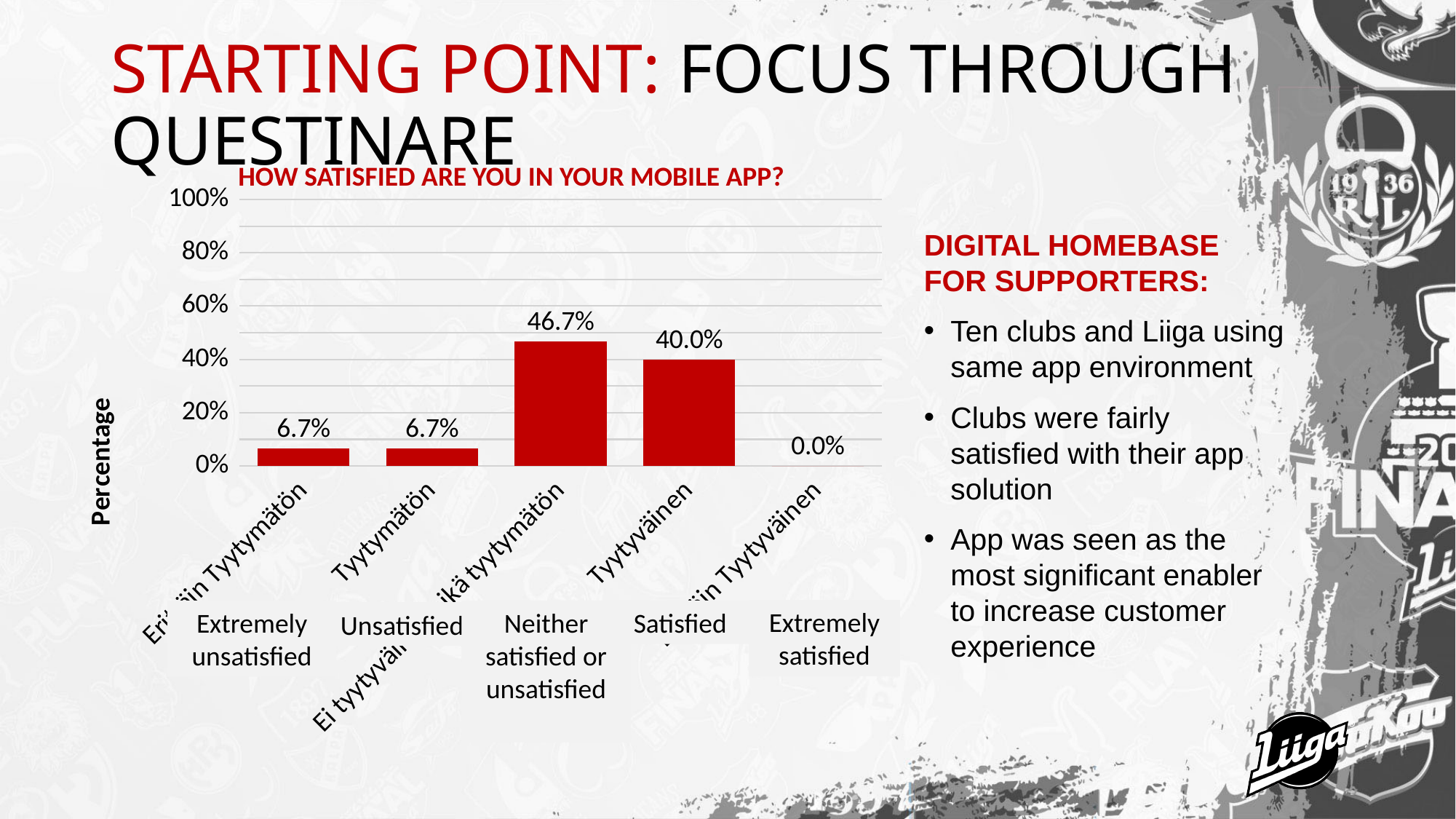
How many categories are shown on the x axis of the chart? 5 What is the value shown for the "Satisfied" category? 40.0% What is the value shown for "Extremely satisfied"? 0.0% What is the difference between the "Neither satisfied or unsatisfied" value and the "Satisfied" value? 6.7% Which category has the highest value? Neither satisfied or unsatisfied What type of chart is used to show the satisfaction results? Bar chart Is the value for "Satisfied" greater or less than 20%? greater What is the value shown for "Extremely unsatisfied"? 6.7% What percentage of respondents answered "Neither satisfied or unsatisfied"? 46.7% Which is larger, the value for "Satisfied" or the value for "Unsatisfied"? Satisfied What is the title of the chart? HOW SATISFIED ARE YOU IN YOUR MOBILE APP? Which category has the lowest value? Extremely satisfied